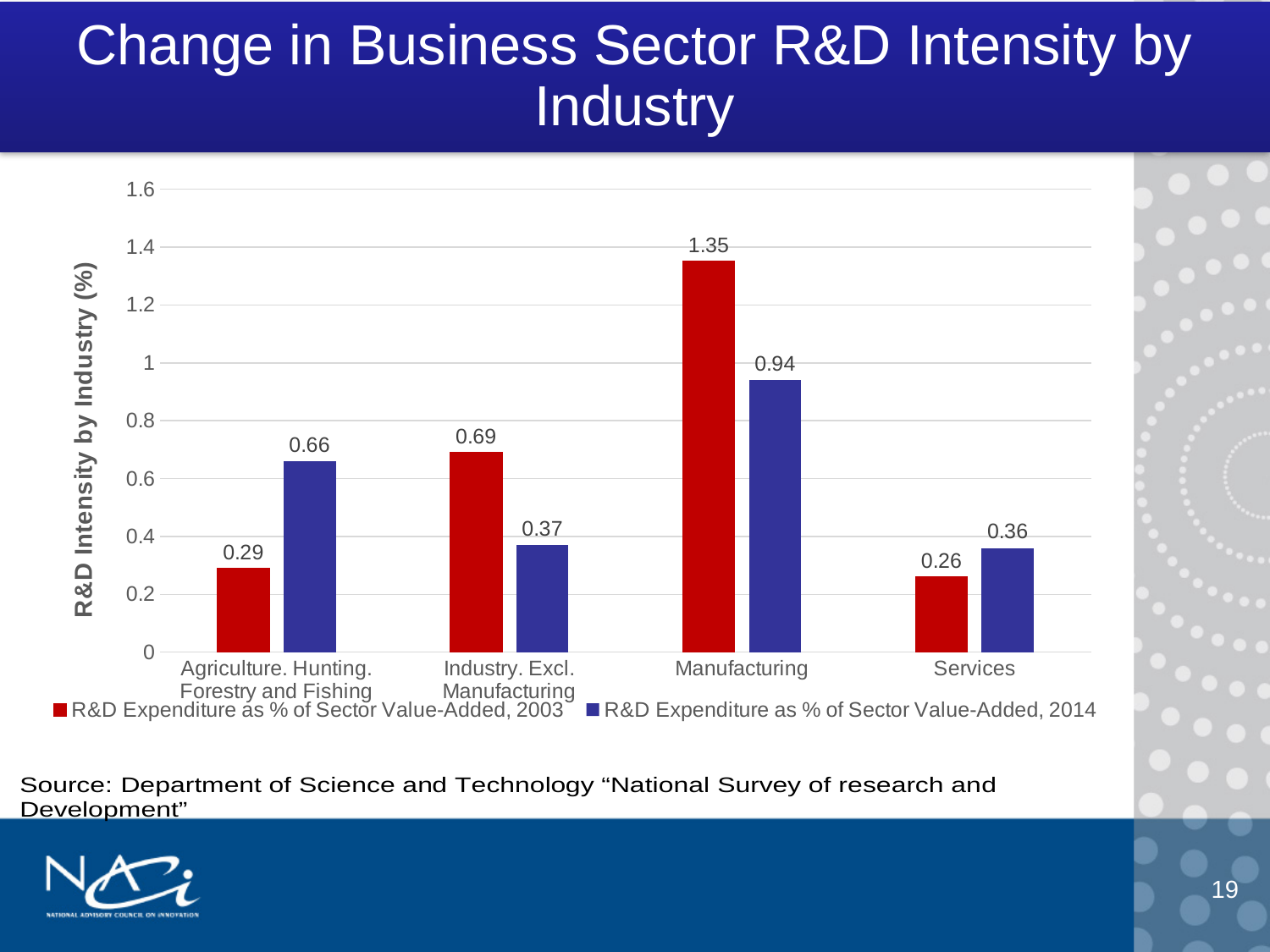
What is the difference between the 2003 and 2014 values for Industry, Excl. Manufacturing? 0.32 Which is larger for Agriculture, Hunting, Forestry and Fishing: the 2003 value or the 2014 value? 2014 How many series does the legend list? 2 Which industry has the highest 2003 R&D intensity? Manufacturing Which industry has the lowest 2003 R&D intensity? Services What is the difference between the 2003 and 2014 values for Manufacturing? 0.41 What is the 2014 value for Agriculture, Hunting, Forestry and Fishing? 0.66 What is the 2003 R&D expenditure as % of sector value-added for Manufacturing? 1.35 What kind of chart is shown on the slide? Bar chart Is the 2014 value for Manufacturing greater or less than 1? less How many industry categories are shown on the x axis? 4 What is the 2014 R&D expenditure as % of sector value-added for Services? 0.36